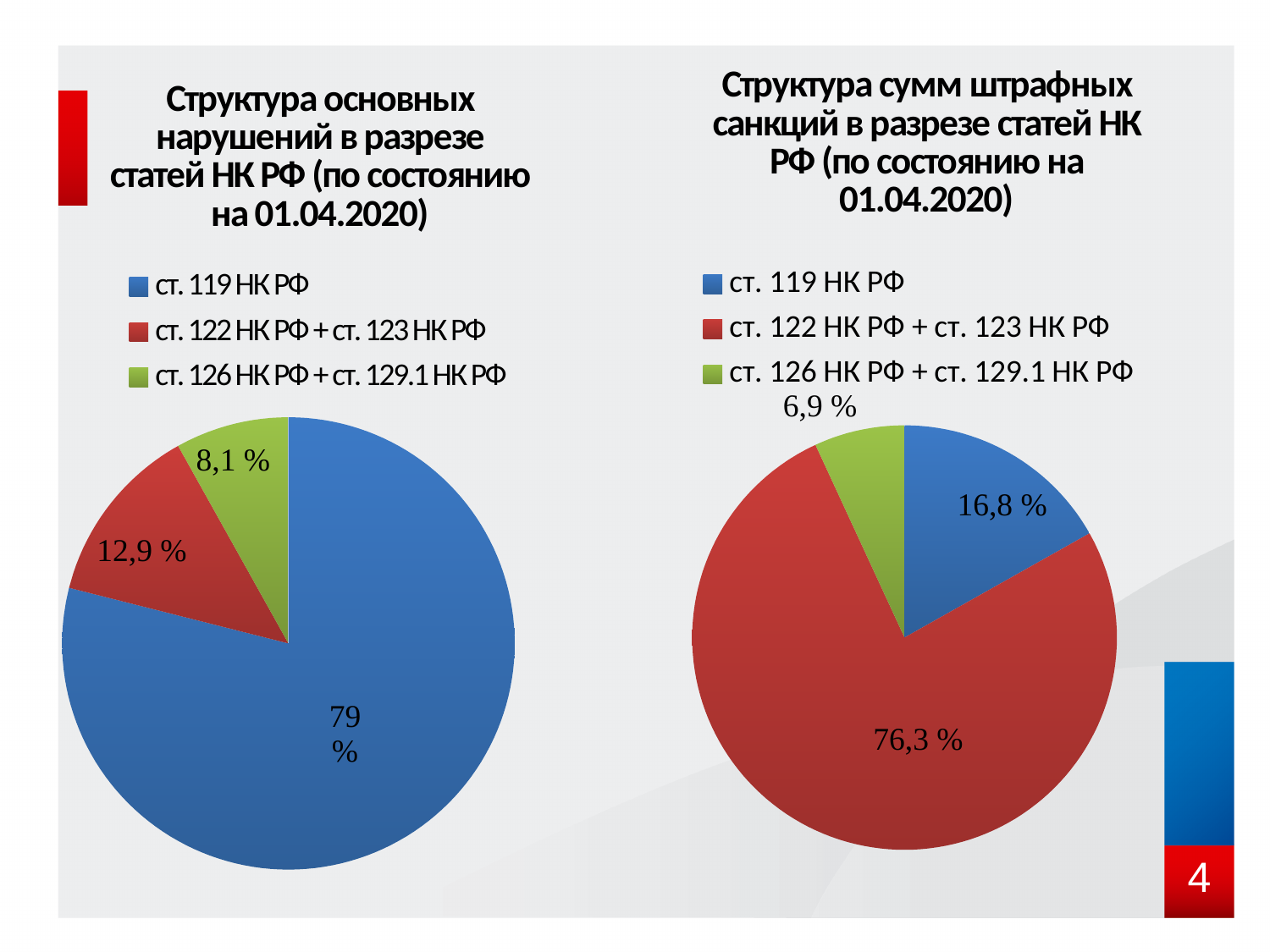
In the right pie chart, what share is shown for ст. 126 НК РФ + ст. 129.1 НК РФ? 6,9 % In the right pie chart, which category has the smallest slice? ст. 126 НК РФ + ст. 129.1 НК РФ In the right pie chart, what share is shown for ст. 122 НК РФ + ст. 123 НК РФ? 76,3 % In the left pie chart, what share is shown for ст. 126 НК РФ + ст. 129.1 НК РФ? 8,1 % In the left pie chart, which category has the largest slice? ст. 119 НК РФ In the left pie chart, what share is shown for ст. 119 НК РФ? 79 % In the left pie chart, what is the difference between the share for ст. 122 НК РФ + ст. 123 НК РФ and the share for ст. 126 НК РФ + ст. 129.1 НК РФ? 4,8 % In the right pie chart, which is larger: the slice for ст. 119 НК РФ or the slice for ст. 122 НК РФ + ст. 123 НК РФ? ст. 122 НК РФ + ст. 123 НК РФ In the left pie chart, what share is shown for ст. 122 НК РФ + ст. 123 НК РФ? 12,9 % How many slices does the right pie chart have? 3 What type of chart is used on the left side of the slide? Pie chart In the right pie chart, what share is shown for ст. 119 НК РФ? 16,8 %